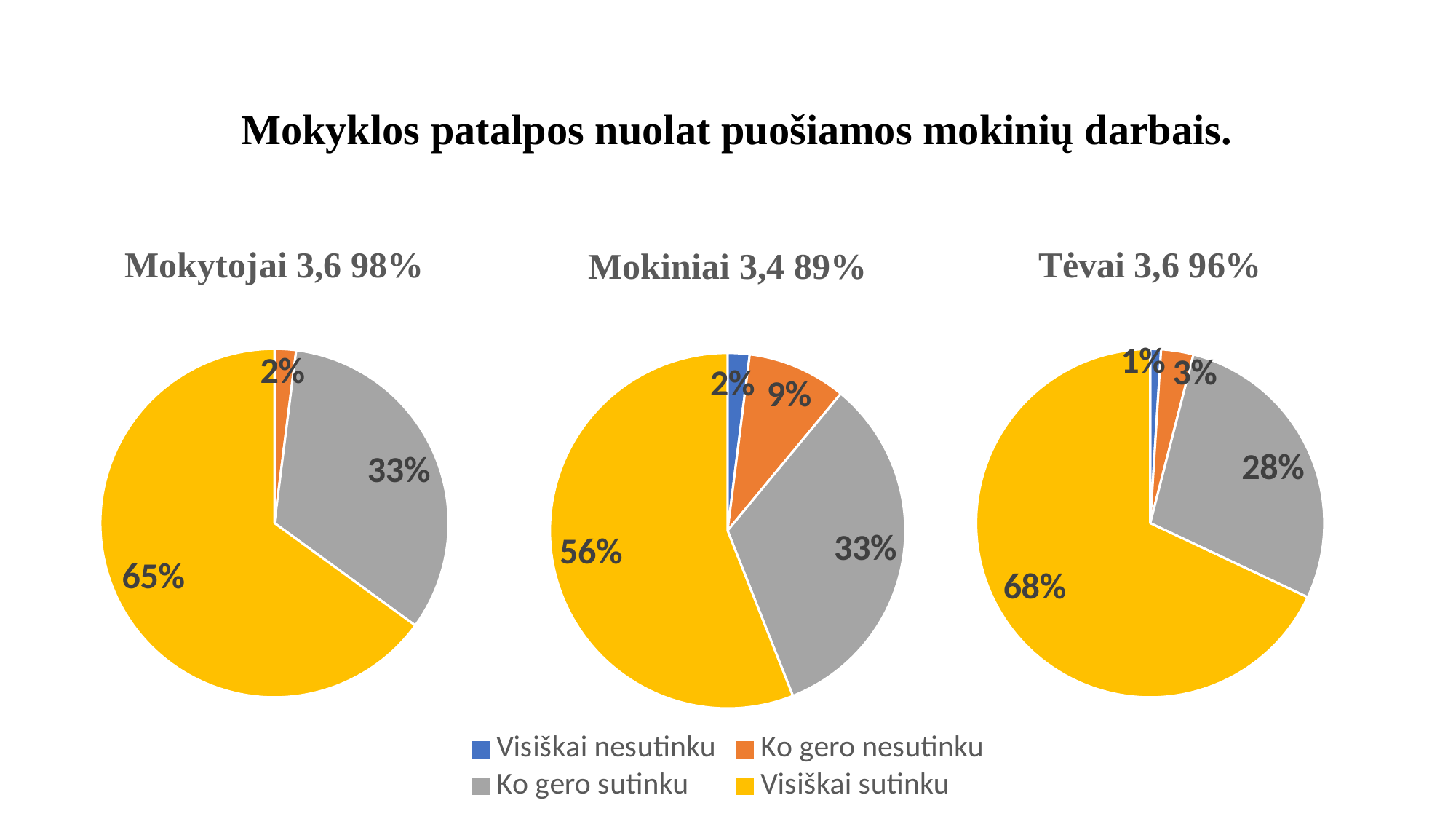
In the "Mokiniai 3,4 89%" chart, which category has the largest slice? Visiškai sutinku How many slices does the "Mokiniai 3,4 89%" chart have? 4 What type of chart is used on this slide? Pie chart In the "Tėvai 3,6 96%" chart, what share is "Ko gero sutinku"? 28% In the "Mokytojai 3,6 98%" chart, what share is "Visiškai sutinku"? 65% In the "Mokiniai 3,4 89%" chart, which category has the smallest slice? Visiškai nesutinku In the "Mokiniai 3,4 89%" chart, what share is "Ko gero nesutinku"? 9% Which is larger: the "Visiškai sutinku" share in the "Mokytojai 3,6 98%" chart or in the "Tėvai 3,6 96%" chart? Tėvai 3,6 96% In the "Mokiniai 3,4 89%" chart, what is the difference between the "Visiškai sutinku" and "Ko gero sutinku" shares? 23% What colour represents "Ko gero sutinku" in the legend? Gray How many entries does the legend list? 4 In the "Tėvai 3,6 96%" chart, what share is "Visiškai nesutinku"? 1%